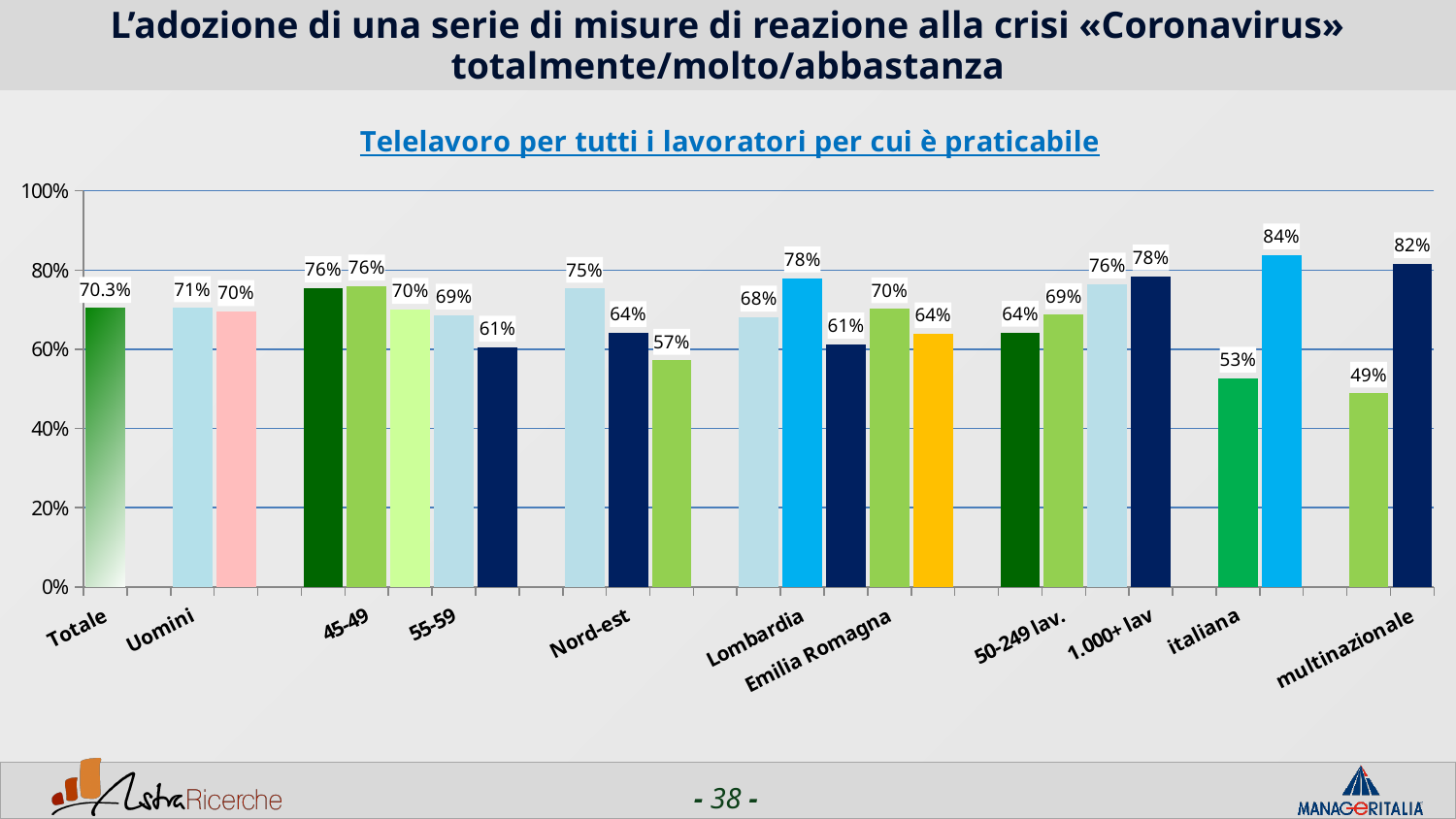
What is the title of the chart? Telelavoro per tutti i lavoratori per cui è praticabile What is the value for Lombardia? 78% What is the value for Uomini? 71% Which is larger, the value for Lombardia or the value for Uomini? Lombardia Is the value for Totale greater or less than 60%? greater What is the difference between the values for multinazionale and italiana? 29 percentage points What is the lowest value shown by any bar in the chart? 49% What is the value for multinazionale? 82% What is the value for italiana? 53% What type of chart is shown on the slide? bar chart What is the value for Totale? 70.3% What is the highest value shown by any bar in the chart? 84%